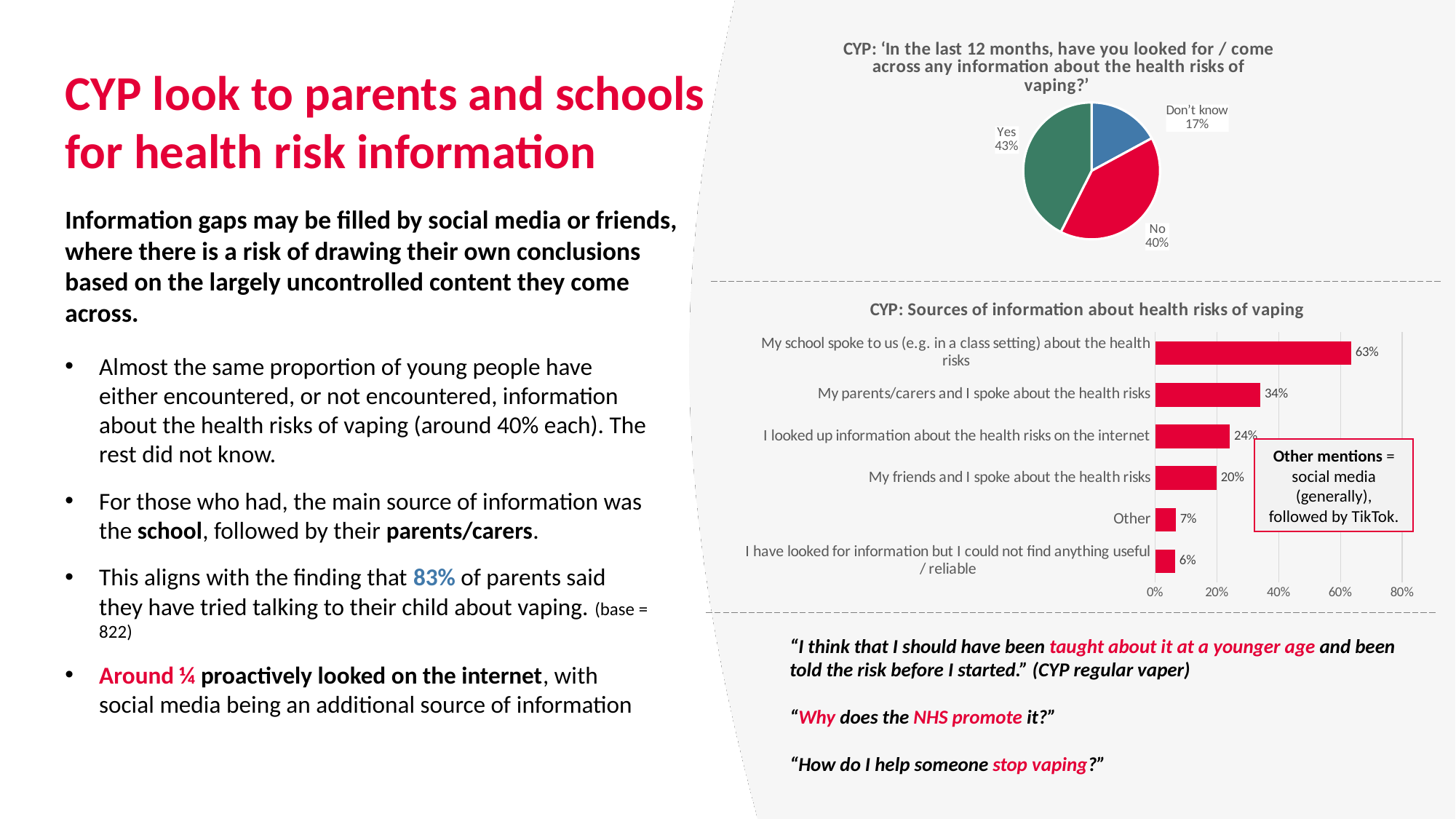
In the pie chart at the top right, how many slices are there? 3 In the pie chart at the top right, what is the difference between the 'Yes' and 'No' shares? 3% In the pie chart at the top right, what percentage answered 'Don't know'? 17% In the chart 'CYP: Sources of information about health risks of vaping', which is larger: 'I looked up information about the health risks on the internet' or 'My friends and I spoke about the health risks'? I looked up information about the health risks on the internet In the chart 'CYP: Sources of information about health risks of vaping', which category has the lowest value? I have looked for information but I could not find anything useful / reliable In the chart 'CYP: Sources of information about health risks of vaping', which source has the highest value? My school spoke to us (e.g. in a class setting) about the health risks In the chart 'CYP: Sources of information about health risks of vaping', how many categories are shown? 6 In the chart 'CYP: Sources of information about health risks of vaping', what is the value for 'My parents/carers and I spoke about the health risks'? 34% What type of chart is 'CYP: Sources of information about health risks of vaping'? Bar chart In the chart 'CYP: Sources of information about health risks of vaping', what is the difference between the school value and the parents/carers value? 29% In the pie chart 'In the last 12 months, have you looked for / come across any information about the health risks of vaping?', what share answered 'Yes'? 43% In the pie chart at the top right, which response has the smallest share? Don't know